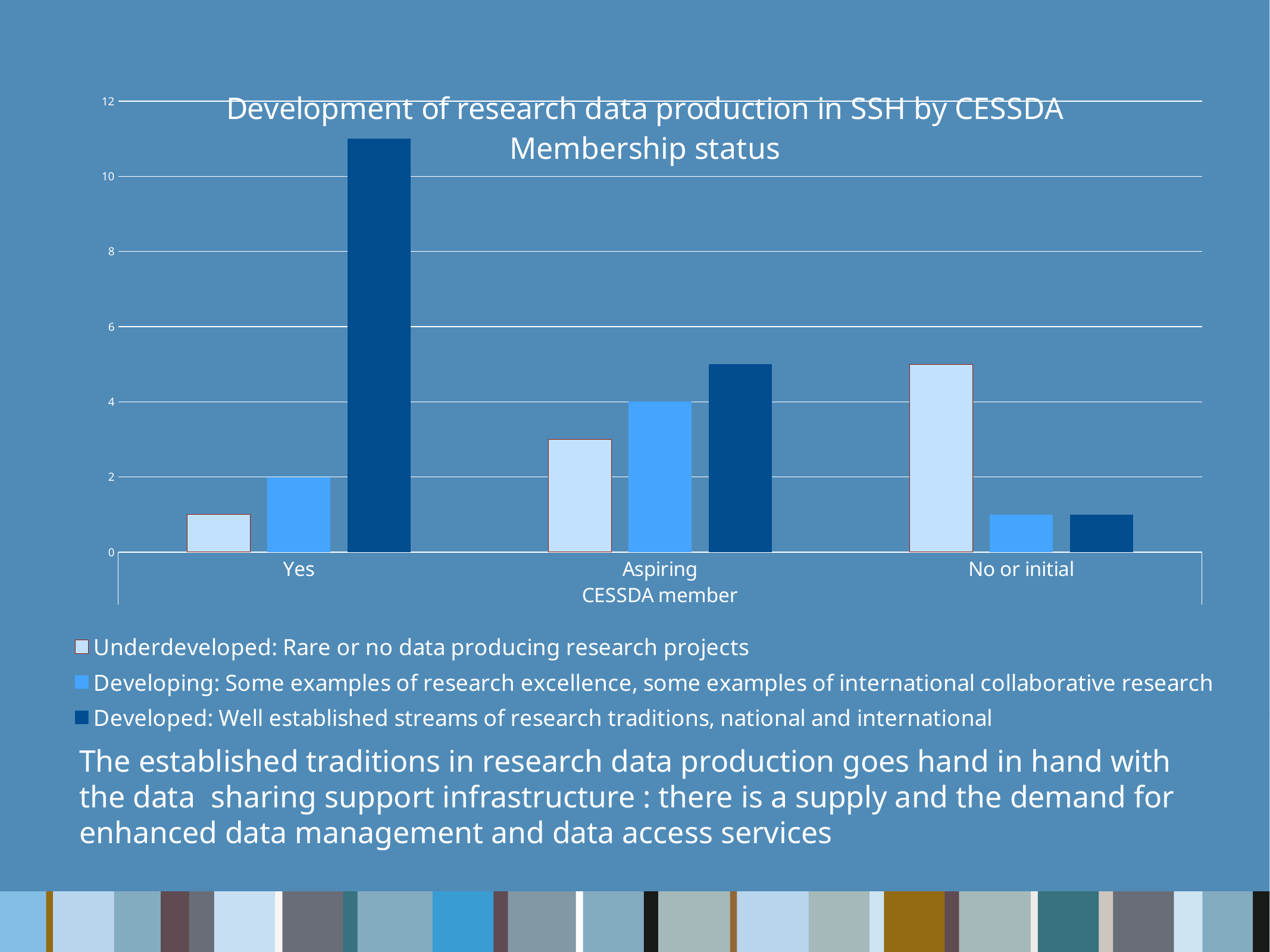
What kind of chart is shown on the slide? bar chart For the 'Aspiring' category, which is larger: the Developed bar or the Underdeveloped bar? Developed Which category has the highest Developed bar? Yes What is the title of the chart? Development of research data production in SSH by CESSDA Membership status Which category has the highest Underdeveloped bar? No or initial Is the Underdeveloped value for 'Aspiring' greater or less than 4? less What is the value of the Developing series for the 'Aspiring' category? 4 Is the Developed value for 'Yes' greater or less than 10? greater How many CESSDA membership categories are shown on the x axis? 3 How many series does the legend list? 3 What is the value of the Developing series for the 'Yes' category? 2 Which category has the lowest Developed bar? No or initial